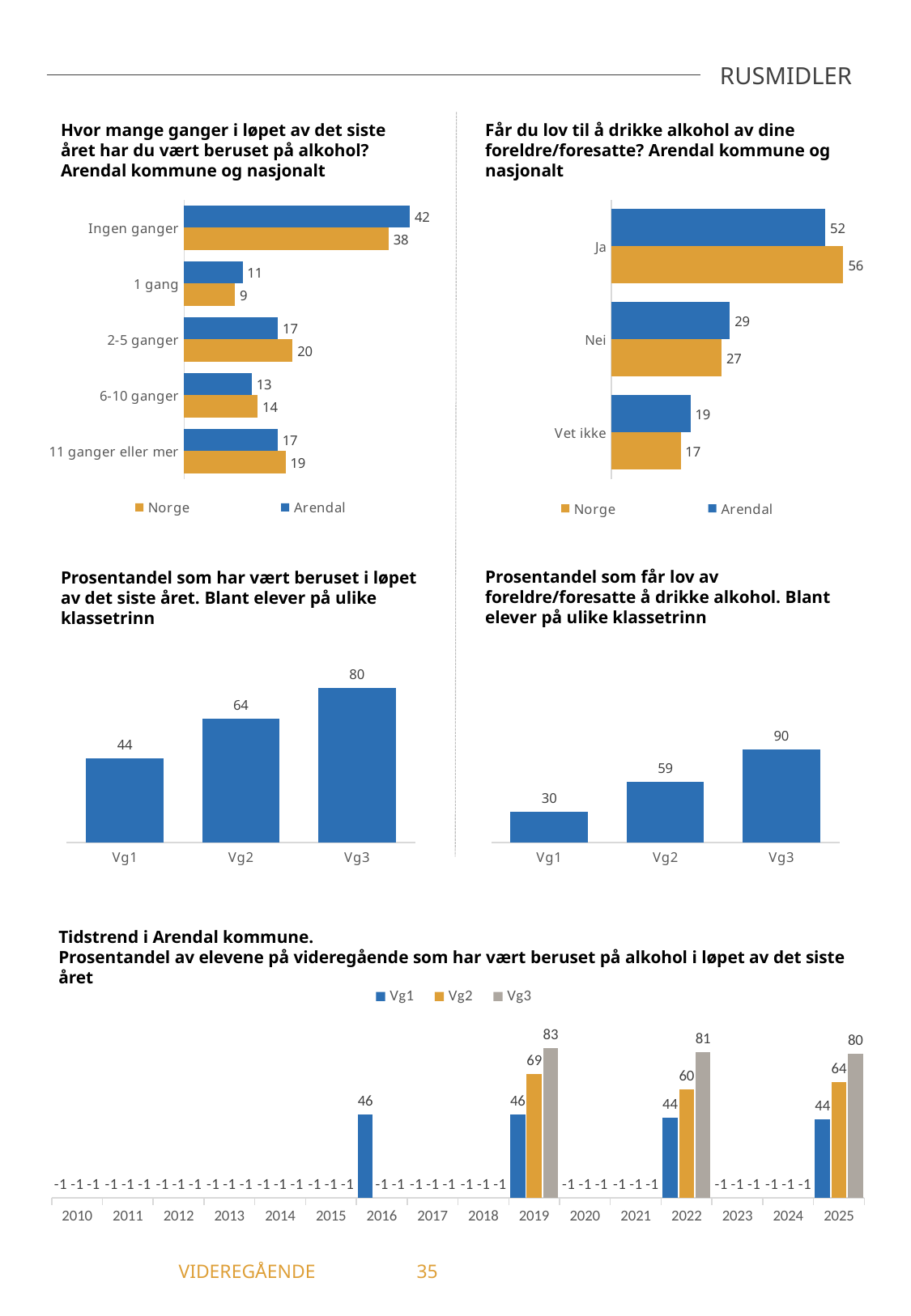
In the chart 'Hvor mange ganger i løpet av det siste året har du vært beruset på alkohol?', what is the value for Arendal for 'Ingen ganger'? 42 In the chart 'Prosentandel som har vært beruset i løpet av det siste året', what is the value for Vg2? 64 In the chart 'Prosentandel som får lov av foreldre/foresatte å drikke alkohol', do the values rise or fall from Vg1 to Vg3? rise In the chart 'Hvor mange ganger i løpet av det siste året har du vært beruset på alkohol?', what is the difference between the Norge and Arendal values for '2-5 ganger'? 3 What kind of chart is 'Tidstrend i Arendal kommune'? bar chart In the chart 'Får du lov til å drikke alkohol av dine foreldre/foresatte?', how many series does the legend list? 2 In the chart 'Hvor mange ganger i løpet av det siste året har du vært beruset på alkohol?', how many categories are shown? 5 In the chart 'Får du lov til å drikke alkohol av dine foreldre/foresatte?', what is the value for Norge for 'Ja'? 56 In the chart 'Får du lov til å drikke alkohol av dine foreldre/foresatte?', which is larger for 'Nei': Arendal or Norge? Arendal In the chart 'Prosentandel som har vært beruset i løpet av det siste året', which class level has the highest value? Vg3 In the chart 'Prosentandel som får lov av foreldre/foresatte å drikke alkohol', what is the difference between Vg3 and Vg1? 60 In the chart 'Tidstrend i Arendal kommune', what is the value for Vg3 in 2019? 83